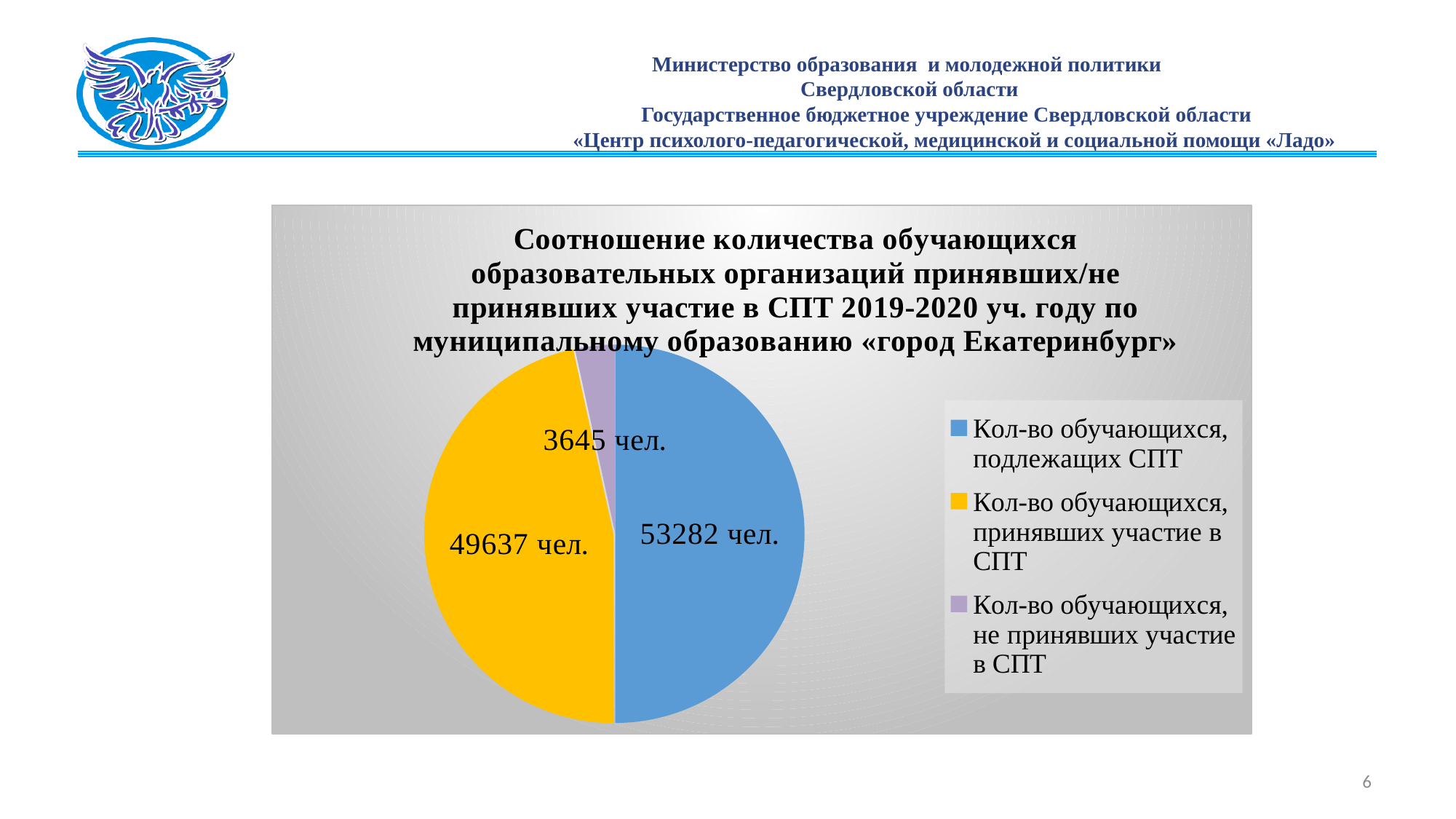
How many slices does the pie chart have? 3 Which category has the smallest slice in the pie chart? Кол-во обучающихся, не принявших участие в СПТ Which category has the largest slice in the pie chart? Кол-во обучающихся, подлежащих СПТ What is the value for "Кол-во обучающихся, не принявших участие в СПТ"? 3645 чел. What is the value for "Кол-во обучающихся, подлежащих СПТ"? 53282 чел. How many entries does the legend of the pie chart list? 3 What is the value for "Кол-во обучающихся, принявших участие в СПТ"? 49637 чел. What kind of chart is shown on the slide? Pie chart What share of the pie does the slice "Кол-во обучающихся, подлежащих СПТ" represent? 50% Which is larger: the number of students who took part in СПТ or the number who did not take part? Кол-во обучающихся, принявших участие в СПТ What is the difference between the number of students subject to СПТ (подлежащих СПТ) and the number who took part (принявших участие в СПТ)? 3645 чел. What colour is the slice for "Кол-во обучающихся, не принявших участие в СПТ"? Purple